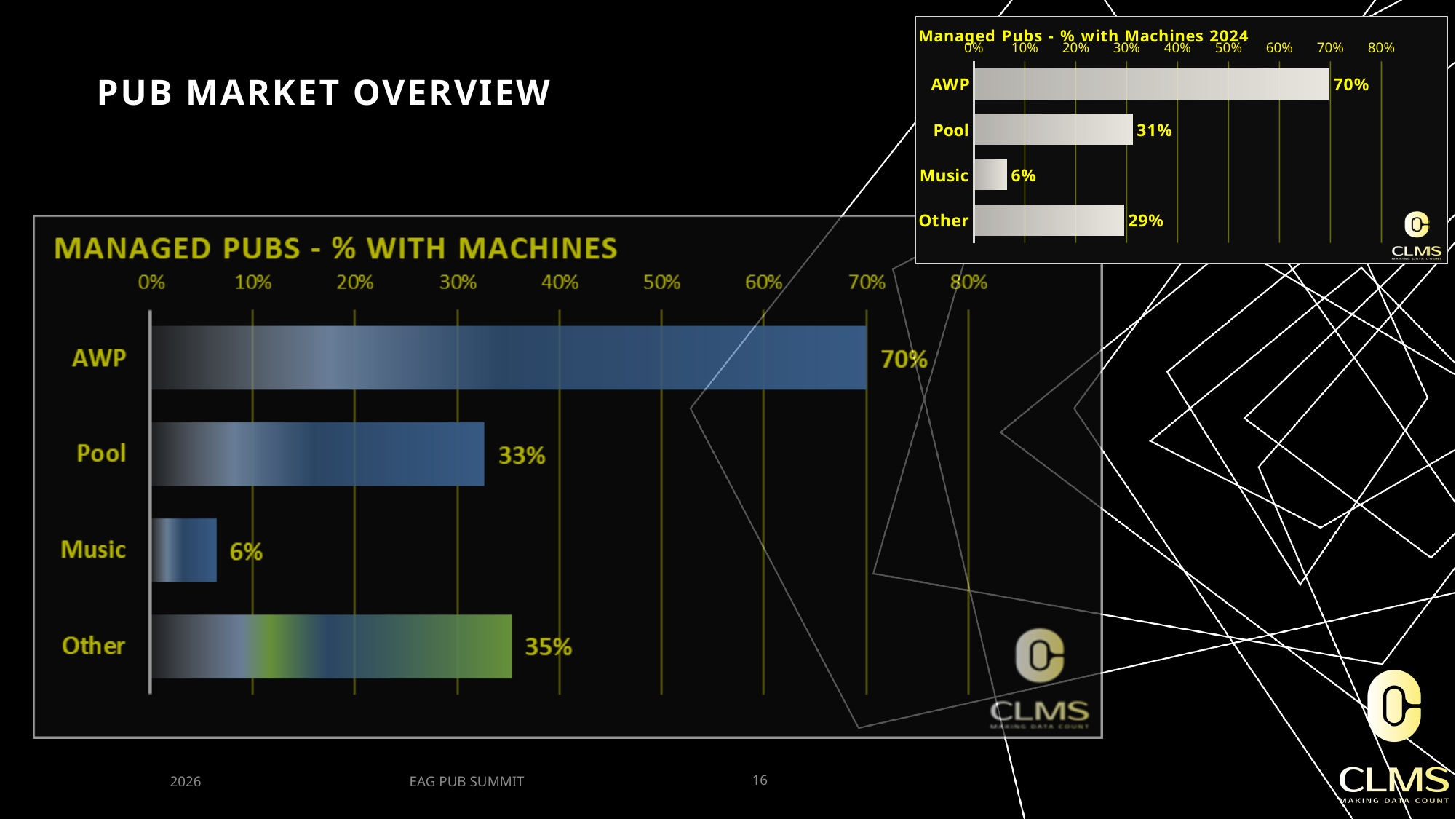
In the large 'MANAGED PUBS - % WITH MACHINES' chart, what is the value for Other? 35% In the large 'MANAGED PUBS - % WITH MACHINES' chart, what is the difference between the AWP and Pool values? 37% In the small 'Managed Pubs - % with Machines 2024' chart in the top right, what is the value for Other? 29% In the small 'Managed Pubs - % with Machines 2024' chart in the top right, what is the difference between the AWP and Music values? 64% In the large 'MANAGED PUBS - % WITH MACHINES' chart, which category has the highest value? AWP In the large 'MANAGED PUBS - % WITH MACHINES' chart, which category has the lowest value? Music What kind of chart is the large 'MANAGED PUBS - % WITH MACHINES' chart? Bar chart In the large 'MANAGED PUBS - % WITH MACHINES' chart, how many categories are shown? 4 In the large 'MANAGED PUBS - % WITH MACHINES' chart, what is the value for Pool? 33% In the small 'Managed Pubs - % with Machines 2024' chart in the top right, what is the value for Pool? 31% In the large 'MANAGED PUBS - % WITH MACHINES' chart, what is the value for AWP? 70% In the small 'Managed Pubs - % with Machines 2024' chart in the top right, which is larger, Pool or Other? Pool